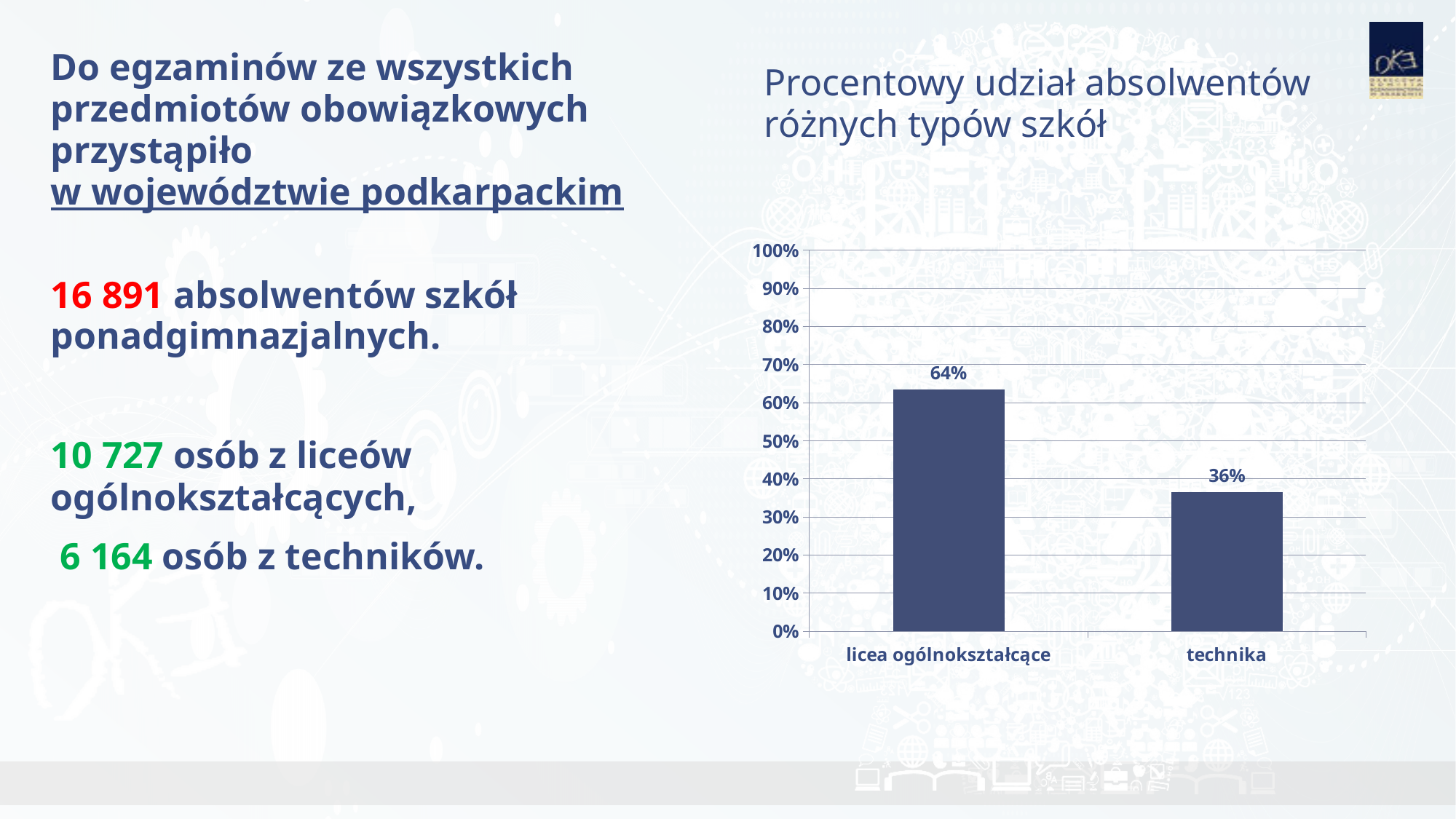
Is the value for licea ogólnokształcące greater or less than 60%? greater What is the value for licea ogólnokształcące? 64% What is the title of the chart? Procentowy udział absolwentów różnych typów szkół What kind of chart is shown on the slide? bar chart What is the highest value shown on the y axis? 100% What is the difference between the values for licea ogólnokształcące and technika? 28% What is the value for technika? 36% Which category has the lowest value? technika Is the value for technika greater or less than 40%? less Which category has the highest value? licea ogólnokształcące How many categories are shown on the x axis? 2 Which is larger, the value for licea ogólnokształcące or the value for technika? licea ogólnokształcące